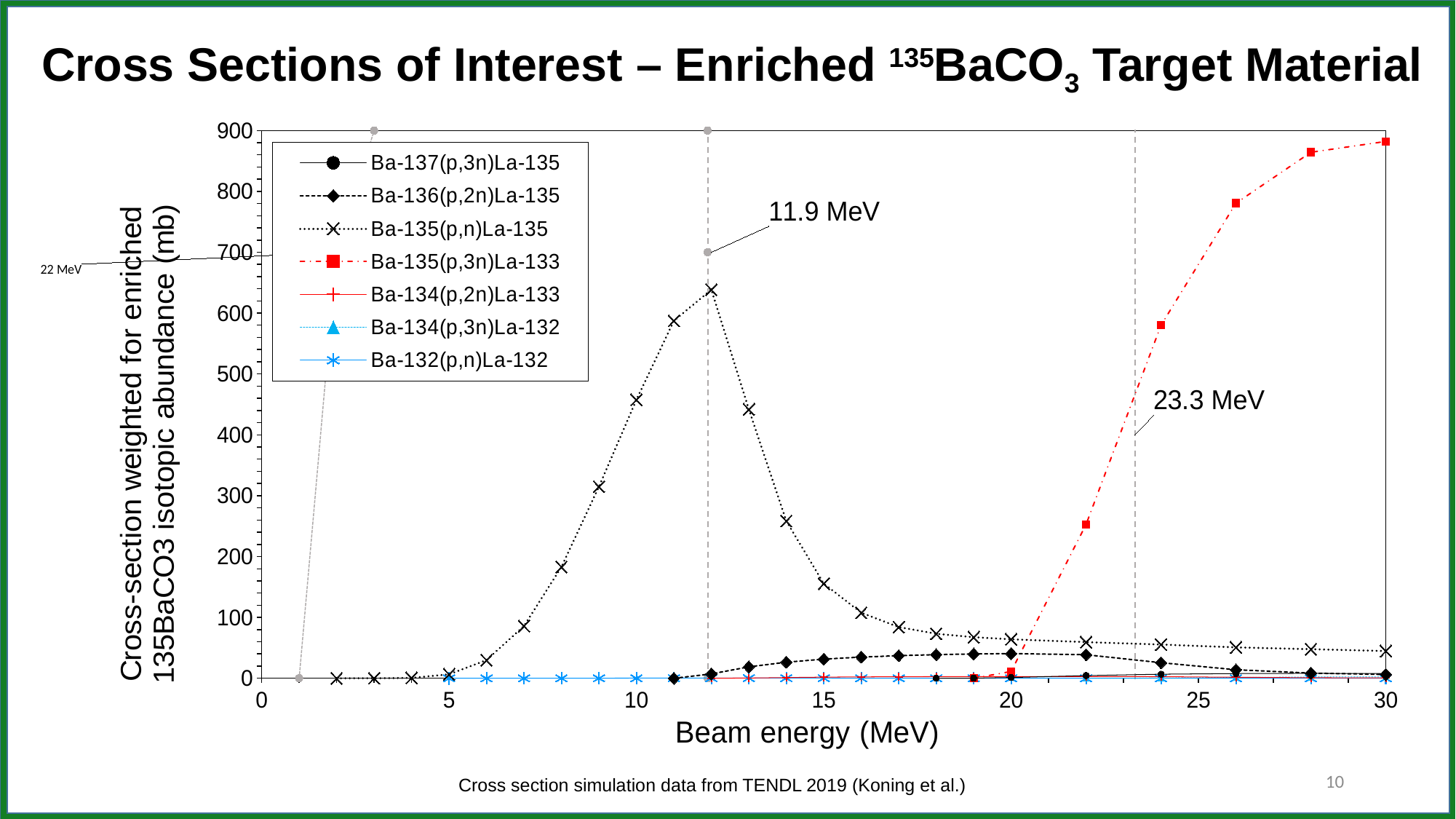
Which series reaches the highest cross-section value on the chart? Ba-135(p,3n)La-133 Is the value for Ba-135(p,n)La-135 at 10 MeV greater or less than 400? greater Is the value for Ba-135(p,n)La-135 at 12 MeV greater or less than 600? greater What is the label of the x axis? Beam energy (MeV) Is the value for Ba-135(p,3n)La-133 at 30 MeV greater or less than 800? greater How many series does the legend list? 7 What kind of chart is shown on the slide? line chart Does the Ba-135(p,3n)La-133 curve rise or fall between 20 MeV and 30 MeV? rise At 12 MeV, which is larger: Ba-135(p,n)La-135 or Ba-136(p,2n)La-135? Ba-135(p,n)La-135 What beam energy is marked by the annotation at the peak of the Ba-135(p,n)La-135 curve? 11.9 MeV At 26 MeV, which is larger: Ba-135(p,3n)La-133 or Ba-135(p,n)La-135? Ba-135(p,3n)La-133